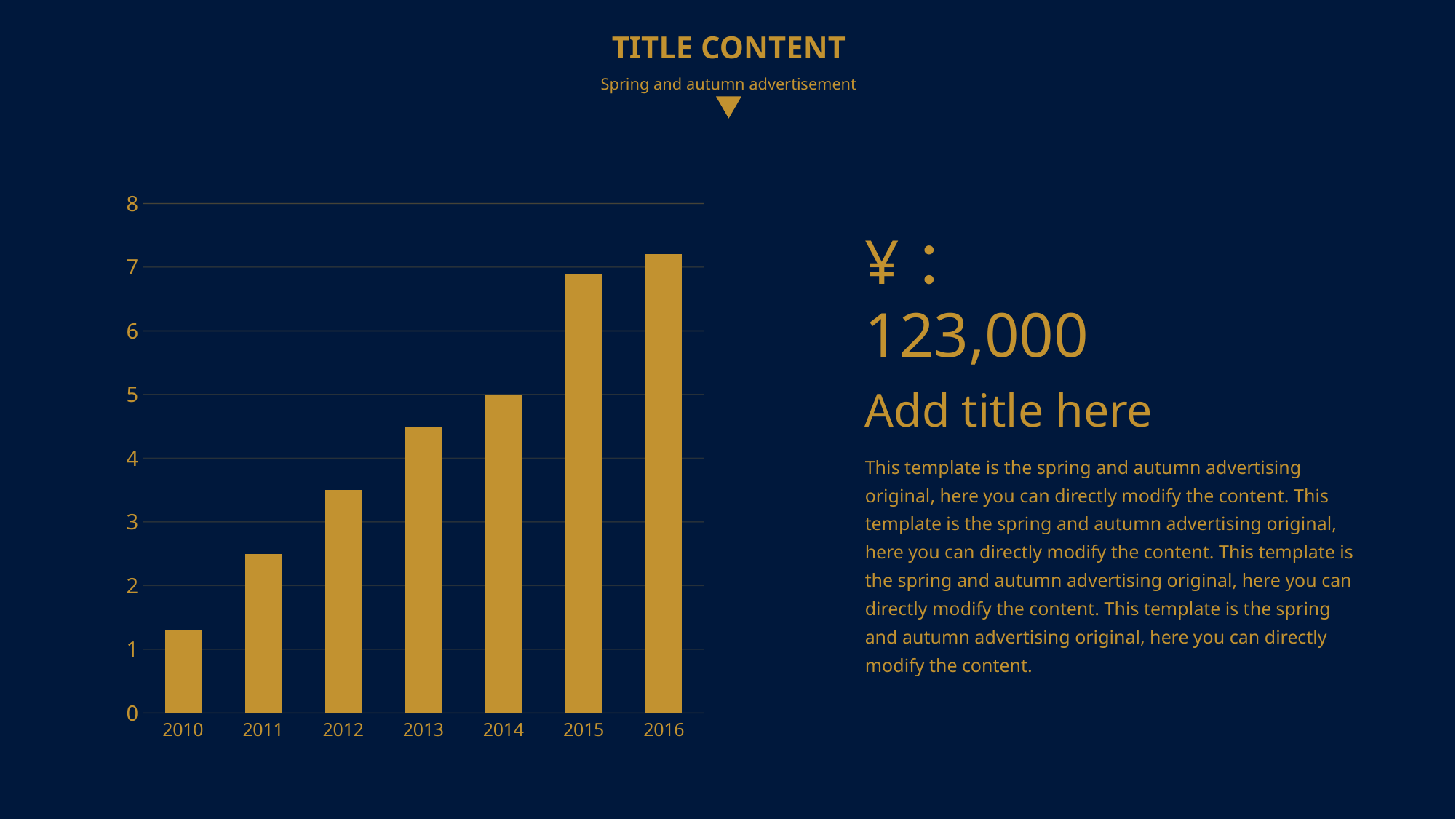
Is the value for 2016 greater or less than 7? greater Which is larger, the value for 2012 or the value for 2013? 2013 Which year has the shortest bar in the chart? 2010 How many years are shown on the x axis of the chart? 7 What kind of chart is shown on the slide? bar chart What is the highest value shown on the chart's vertical axis? 8 Is the value for 2013 greater or less than 4? greater What is the value for 2014 in the chart? 5 Is the value for 2012 greater or less than 3? greater Which year has the tallest bar in the chart? 2016 Do the bar values rise or fall from 2010 to 2016? rise